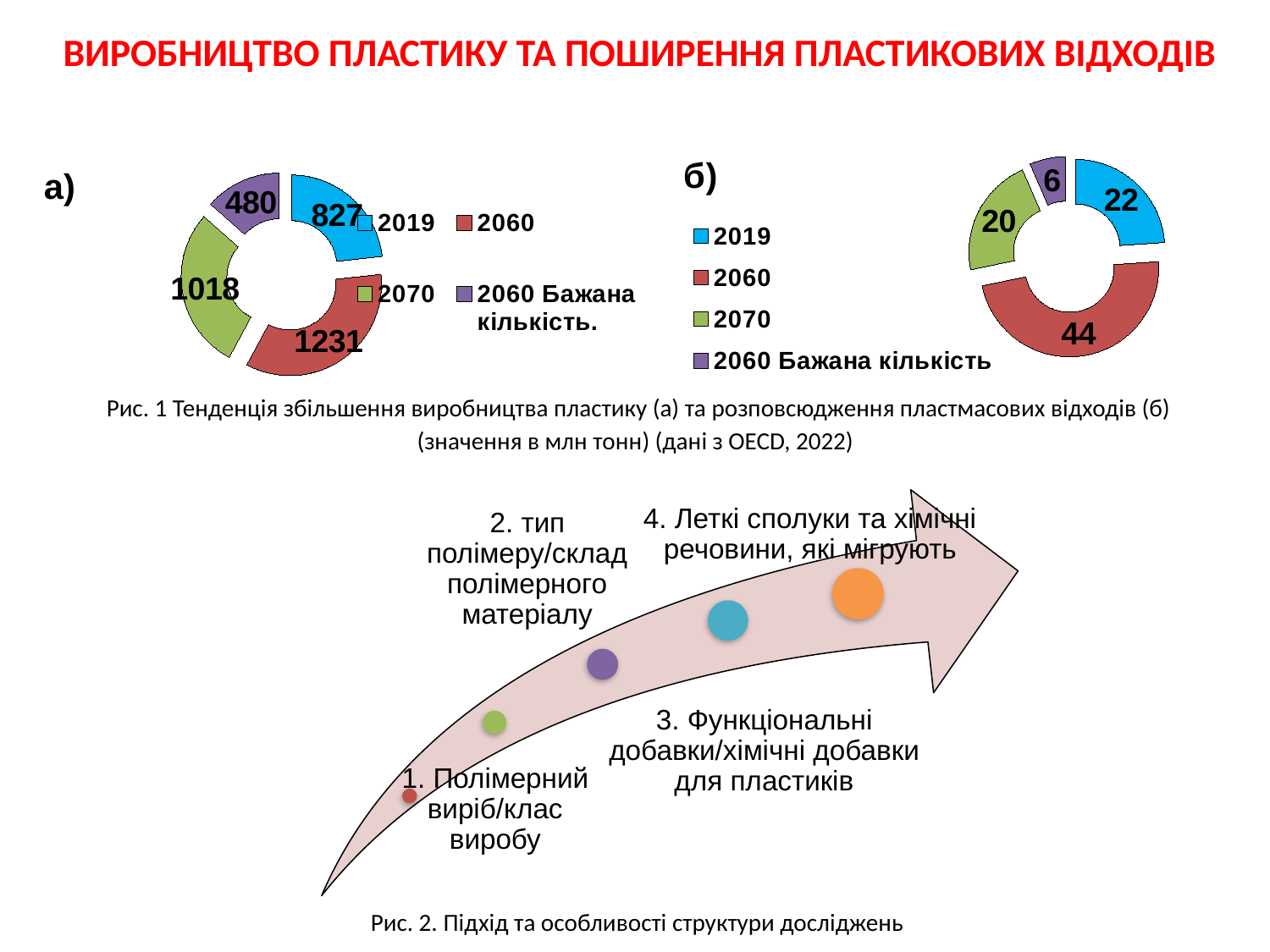
In chart (б) on the right, what is the value for 2060? 44 In chart (а) on the left, which category has the highest value? 2060 In chart (б) on the right, what is the value for "2060 Бажана кількість"? 6 In chart (а) on the left, what is the value for 2019? 827 In chart (а) on the left, what is the value for 2060? 1231 In chart (а) on the left, what is the value for 2070? 1018 How many entries does the legend of chart (б) on the right list? 4 In chart (а) on the left, what is the value for "2060 Бажана кількість"? 480 In chart (б) on the right, which category has the lowest value? 2060 Бажана кількість In chart (а) on the left, what is the difference between the values for 2060 and 2019? 404 In chart (б) on the right, which is larger, the value for 2019 or the value for 2070? 2019 What kind of chart is chart (а) on the left? Doughnut chart